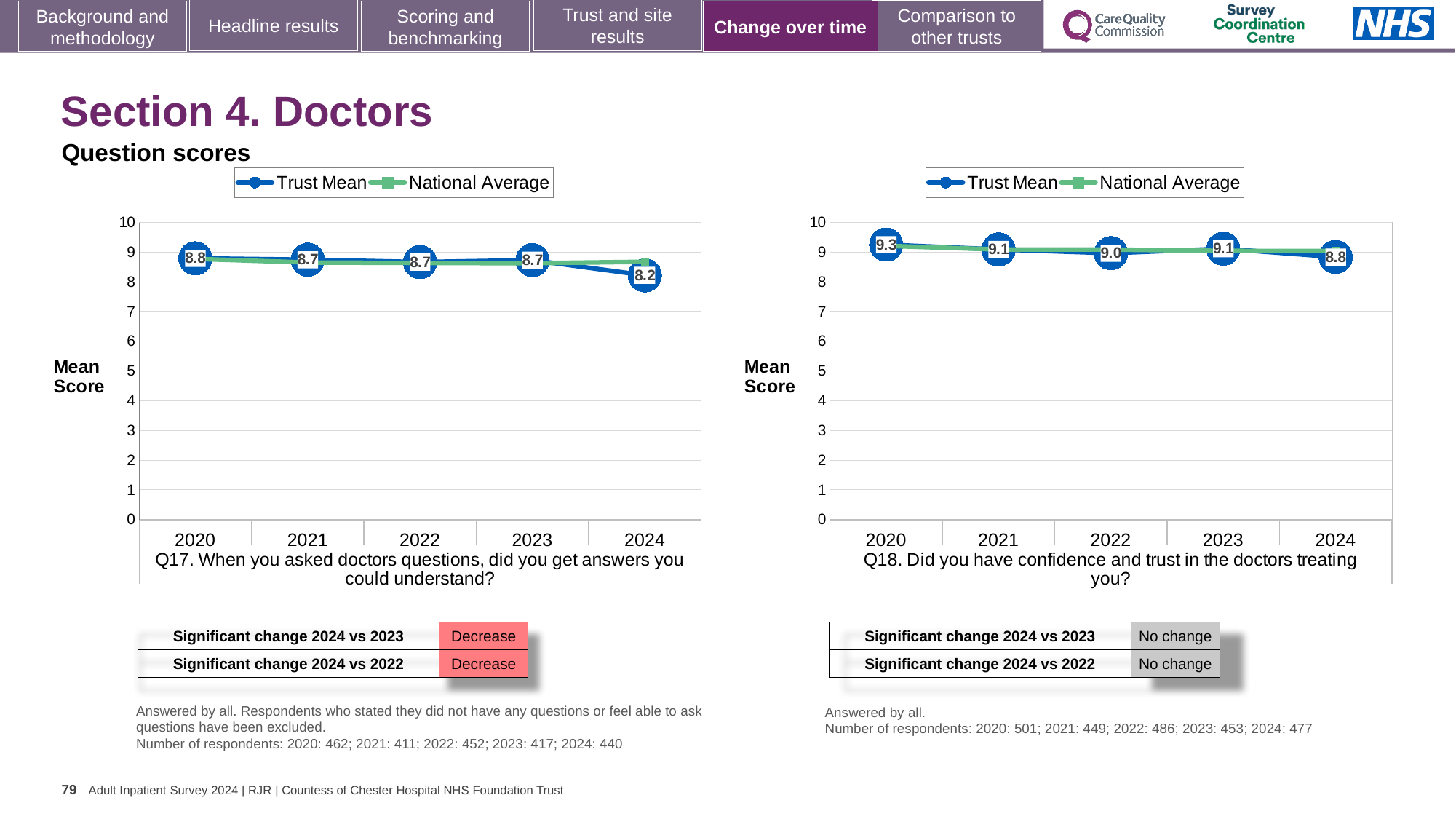
On the Q17 chart, what is the Trust Mean score for 2024? 8.2 How many series does the legend of the Q17 chart list? 2 On the Q17 chart, what is the Trust Mean score for 2020? 8.8 On the Q17 chart, what is the difference between the Trust Mean scores for 2023 and 2024? 0.5 On the Q17 chart, which year has the lowest Trust Mean score? 2024 How many years are plotted on the Q18 chart? 5 What kind of chart is the Q17 chart? line chart On the Q18 chart, is the Trust Mean score for 2021 larger or smaller than the score for 2022? larger On the Q18 chart, which year has the highest Trust Mean score? 2020 On the Q18 chart, what is the Trust Mean score for 2020? 9.3 On the Q18 chart, what is the difference between the Trust Mean scores for 2020 and 2024? 0.5 On the Q18 chart, what is the Trust Mean score for 2022? 9.0